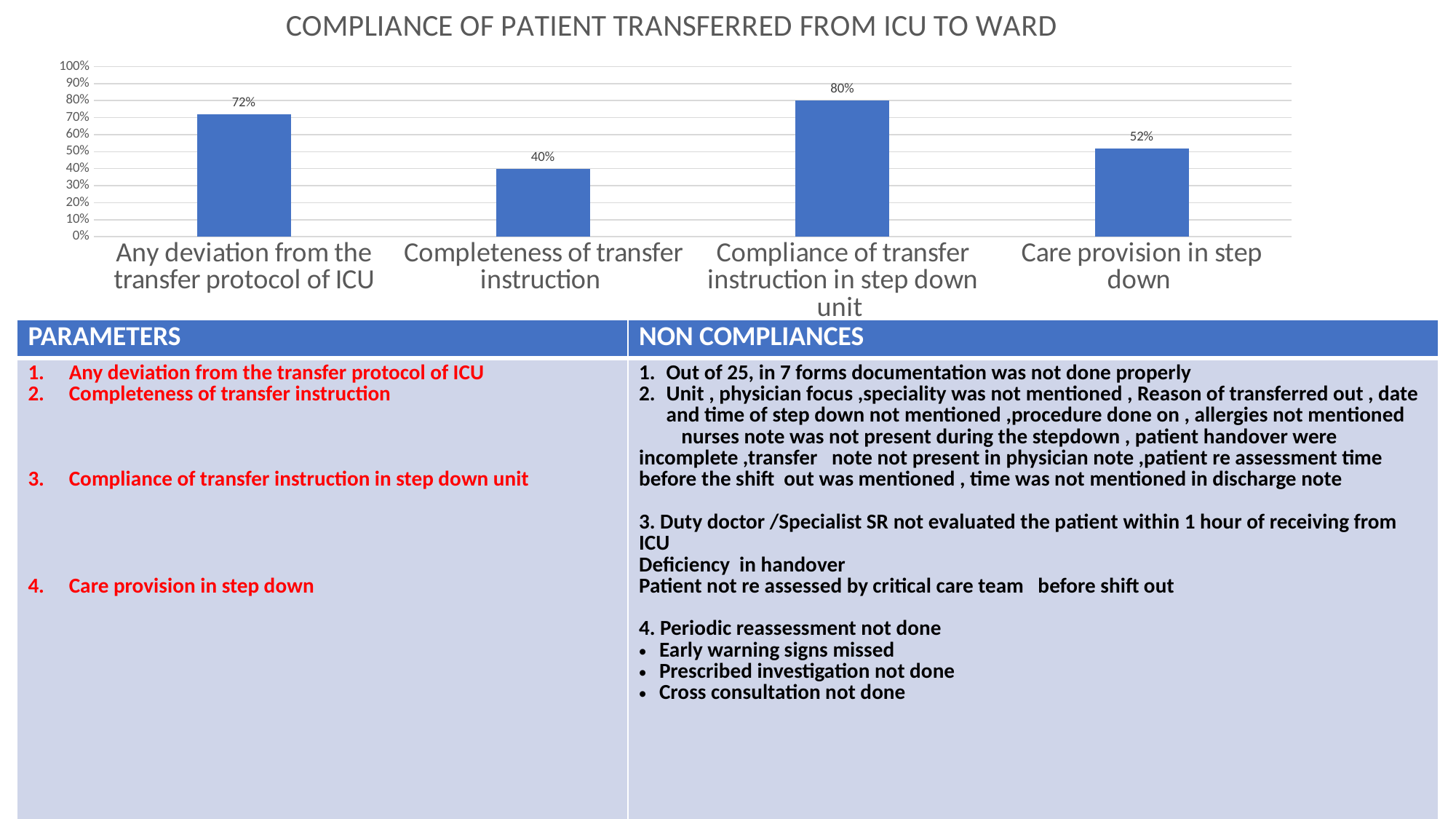
What is the difference between the values for Compliance of transfer instruction in step down unit and Completeness of transfer instruction? 40% What is the value for Care provision in step down? 52% What is the title of the chart? COMPLIANCE OF PATIENT TRANSFERRED FROM ICU TO WARD Is the value for Care provision in step down greater or less than 60%? less Which category has the highest value? Compliance of transfer instruction in step down unit What kind of chart is shown on the slide? bar chart How many categories are shown in the chart? 4 What is the value for Completeness of transfer instruction? 40% Which category has the lowest value? Completeness of transfer instruction Which is larger: the value for Any deviation from the transfer protocol of ICU or the value for Care provision in step down? Any deviation from the transfer protocol of ICU What is the difference between the values for Any deviation from the transfer protocol of ICU and Care provision in step down? 20% What is the value for Any deviation from the transfer protocol of ICU? 72%